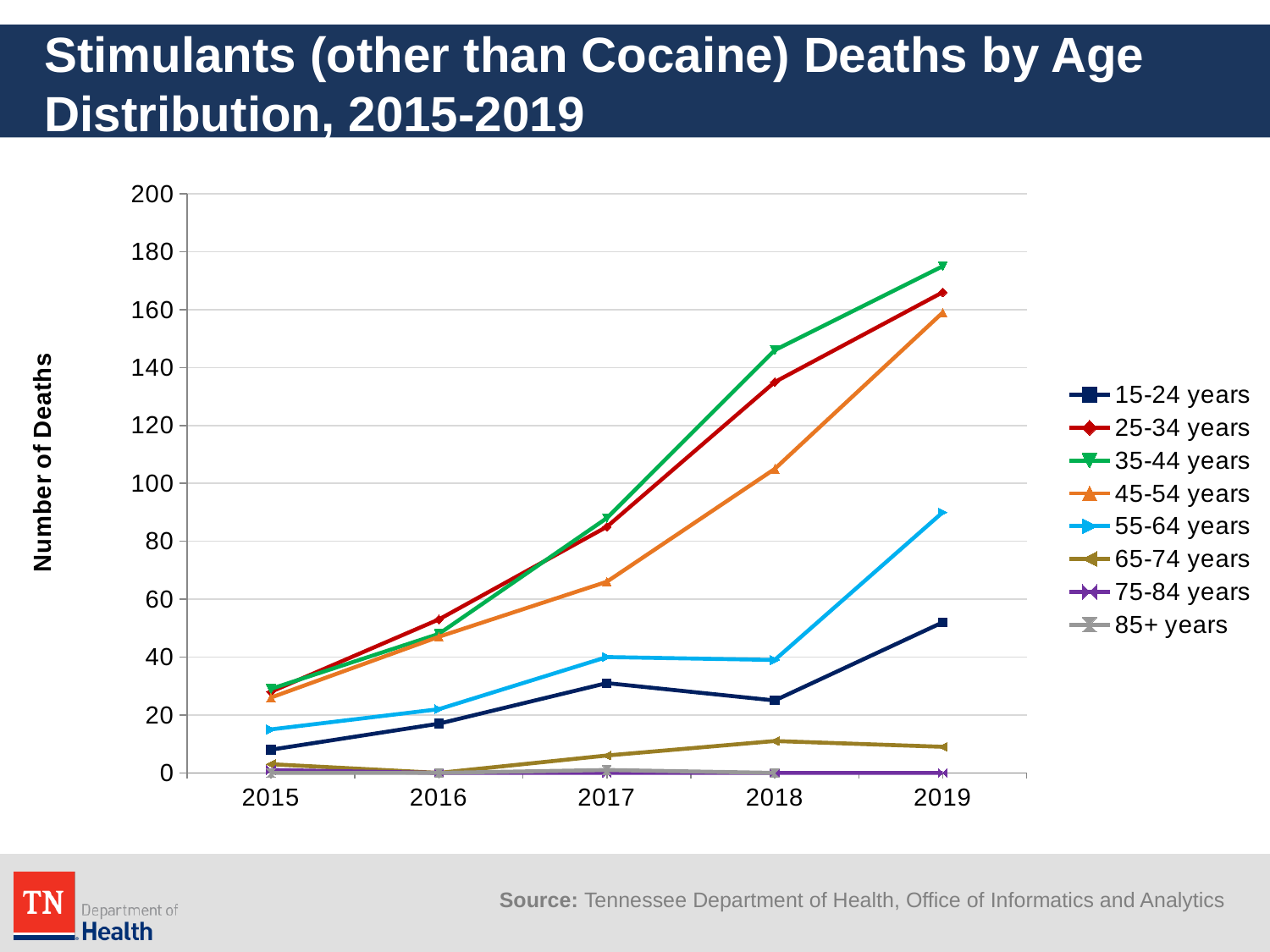
Is the value for 55-64 years in 2019 greater or less than 100? less What kind of chart is shown on the slide? line chart Do the values for 35-44 years rise or fall from 2015 to 2019? rise Is the value for 15-24 years in 2019 greater or less than 40? greater Which age group has the highest number of deaths in 2019? 35-44 years How many years are plotted along the x axis? 5 What is the title of the y axis? Number of Deaths In 2019, which is larger: the value for 25-34 years or the value for 55-64 years? 25-34 years In which year is the value for 35-44 years highest? 2019 Is the value for 55-64 years in 2016 greater or less than 40? less How many series does the legend list? 8